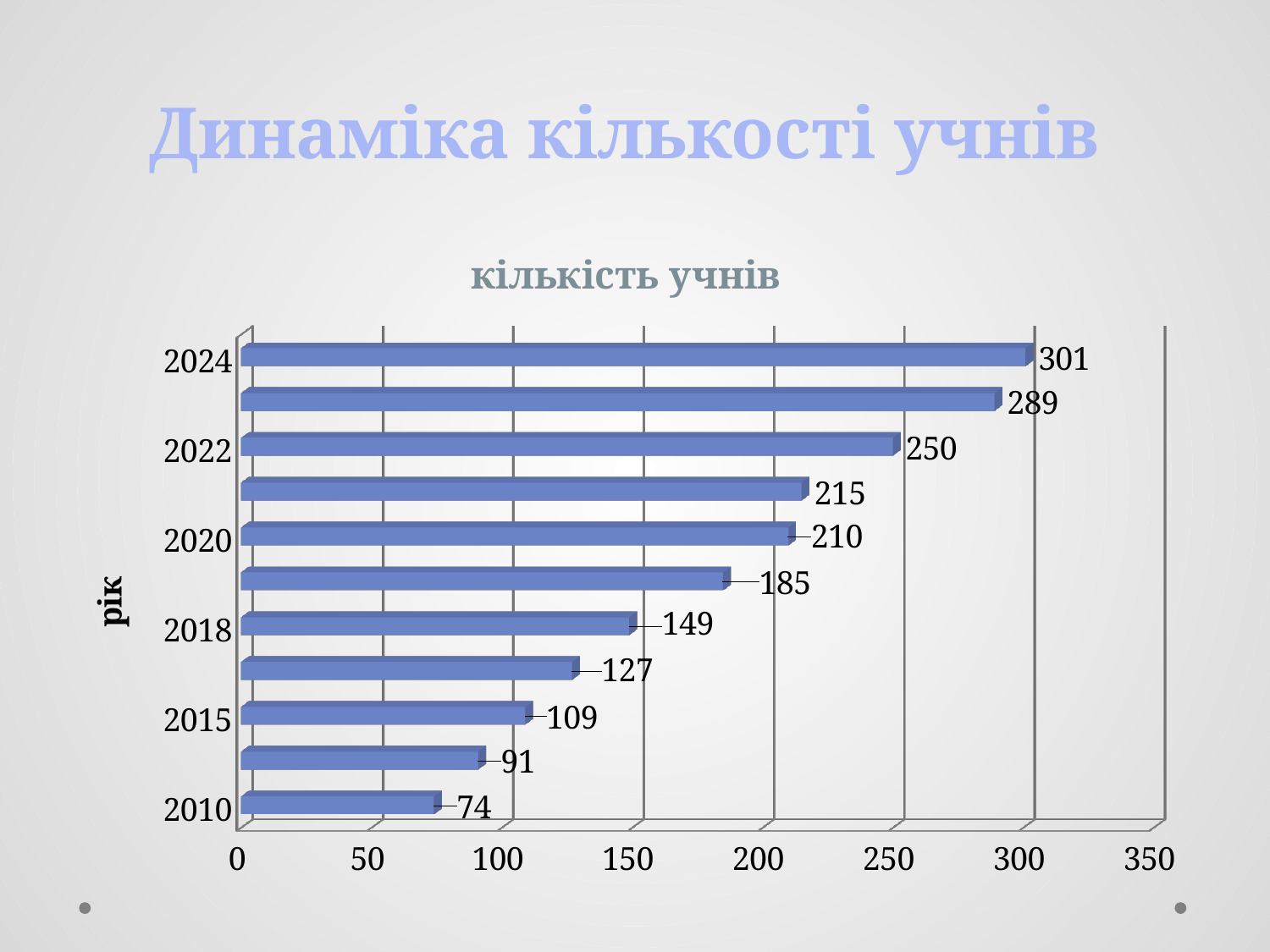
Do the number of students rise or fall from 2010 to 2024? Rise What is the number of students for 2010? 74 What is the difference between the number of students in 2024 and in 2010? 227 Which year has the lowest number of students? 2010 What is the number of students (кількість учнів) for 2024? 301 What is the difference between the number of students in 2022 and in 2020? 40 Which year has the highest number of students? 2024 What type of chart is shown on the slide? Bar chart What is the number of students for 2020? 210 What is the number of students for 2018? 149 How many bars are plotted in the chart? 11 Which year has more students, 2022 or 2015? 2022